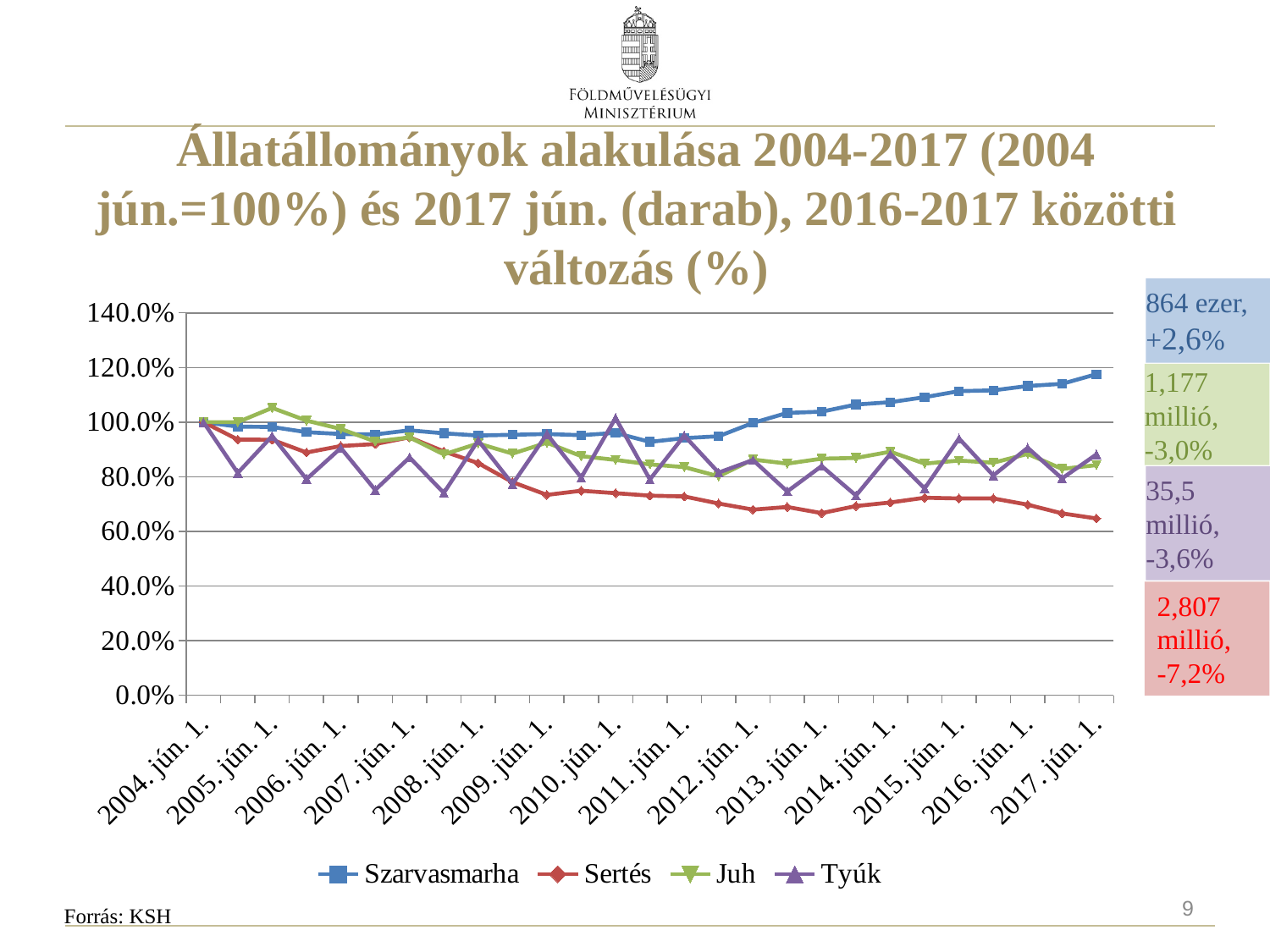
At 2017. jún. 1., which is larger: Szarvasmarha or Sertés? Szarvasmarha Which series are listed in the legend? Szarvasmarha, Sertés, Juh, Tyúk How many years are labelled on the x axis? 14 Which series has the lowest value at 2017. jún. 1.? Sertés What kind of chart is shown on the slide? line chart Is the value for Sertés at 2010. jún. 1. greater or less than 80.0%? less Which series has the highest value at 2017. jún. 1.? Szarvasmarha Is the value for Sertés at 2017. jún. 1. greater or less than 80.0%? less How many series does the legend list? 4 Does the Szarvasmarha series rise or fall from 2012. jún. 1. to 2017. jún. 1.? rise Is the value for Szarvasmarha at 2017. jún. 1. greater or less than 100.0%? greater Does the Sertés series rise or fall overall from 2004. jún. 1. to 2017. jún. 1.? fall